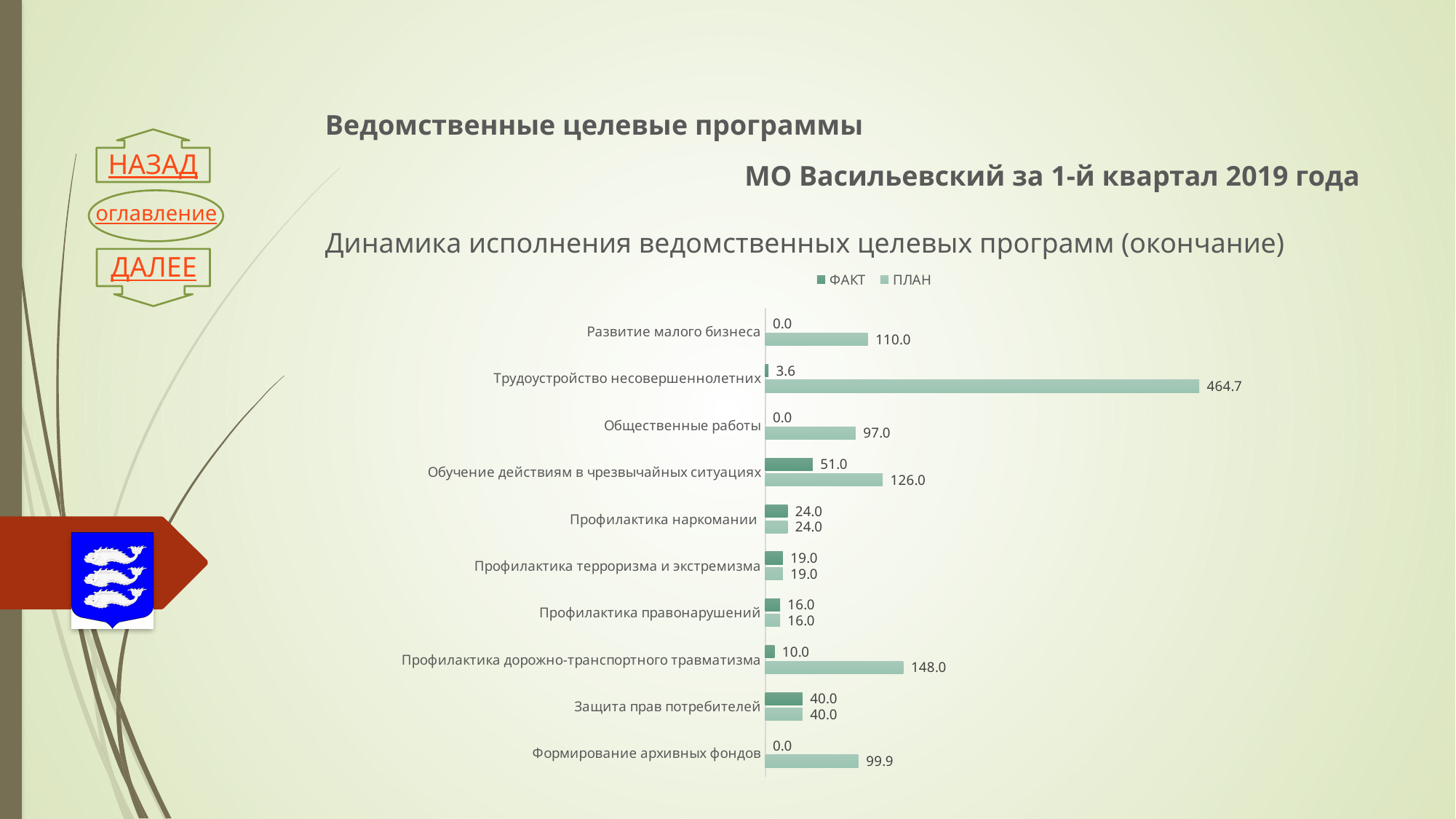
What is the ФАКТ value for Развитие малого бизнеса? 0.0 What is the ФАКТ value for Обучение действиям в чрезвычайных ситуациях? 51.0 Which is larger: the ПЛАН value for Развитие малого бизнеса or the ПЛАН value for Общественные работы? Развитие малого бизнеса What kind of chart is shown on the slide? Bar chart What is the ПЛАН value for Трудоустройство несовершеннолетних? 464.7 How many series does the legend list? 2 What is the difference between the ПЛАН and ФАКТ values for Обучение действиям в чрезвычайных ситуациях? 75.0 What is the ПЛАН value for Профилактика дорожно-транспортного травматизма? 148.0 Which category has the highest ПЛАН value? Трудоустройство несовершеннолетних Which category has the highest ФАКТ value? Обучение действиям в чрезвычайных ситуациях How many categories are shown on the chart? 10 What are the two series named in the chart legend? ФАКТ and ПЛАН